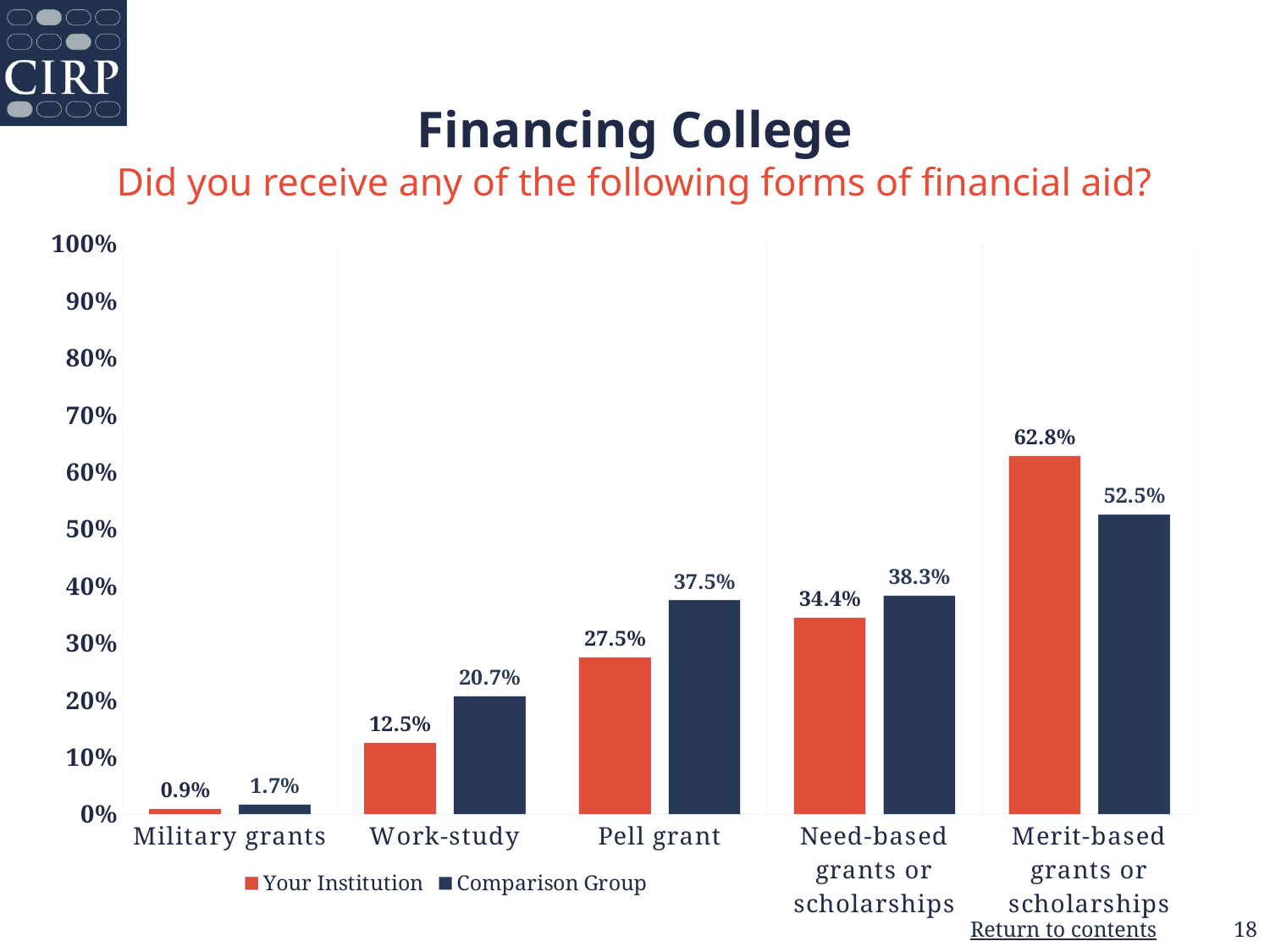
Which category has the highest value for Your Institution? Merit-based grants or scholarships What is the value for Your Institution for Pell grant? 27.5% For Need-based grants or scholarships, which is larger: Your Institution or Comparison Group? Comparison Group How many categories are shown on the x axis? 5 What is the value for Comparison Group for Work-study? 20.7% What kind of chart is shown on the slide? bar chart How many series does the legend list? 2 Which category has the lowest value for Comparison Group? Military grants Is the value for Comparison Group for Merit-based grants or scholarships greater or less than 50%? greater What is the difference between Your Institution and Comparison Group for Merit-based grants or scholarships? 10.3% What is the difference between Comparison Group and Your Institution for Pell grant? 10.0% What is the value for Your Institution for Military grants? 0.9%